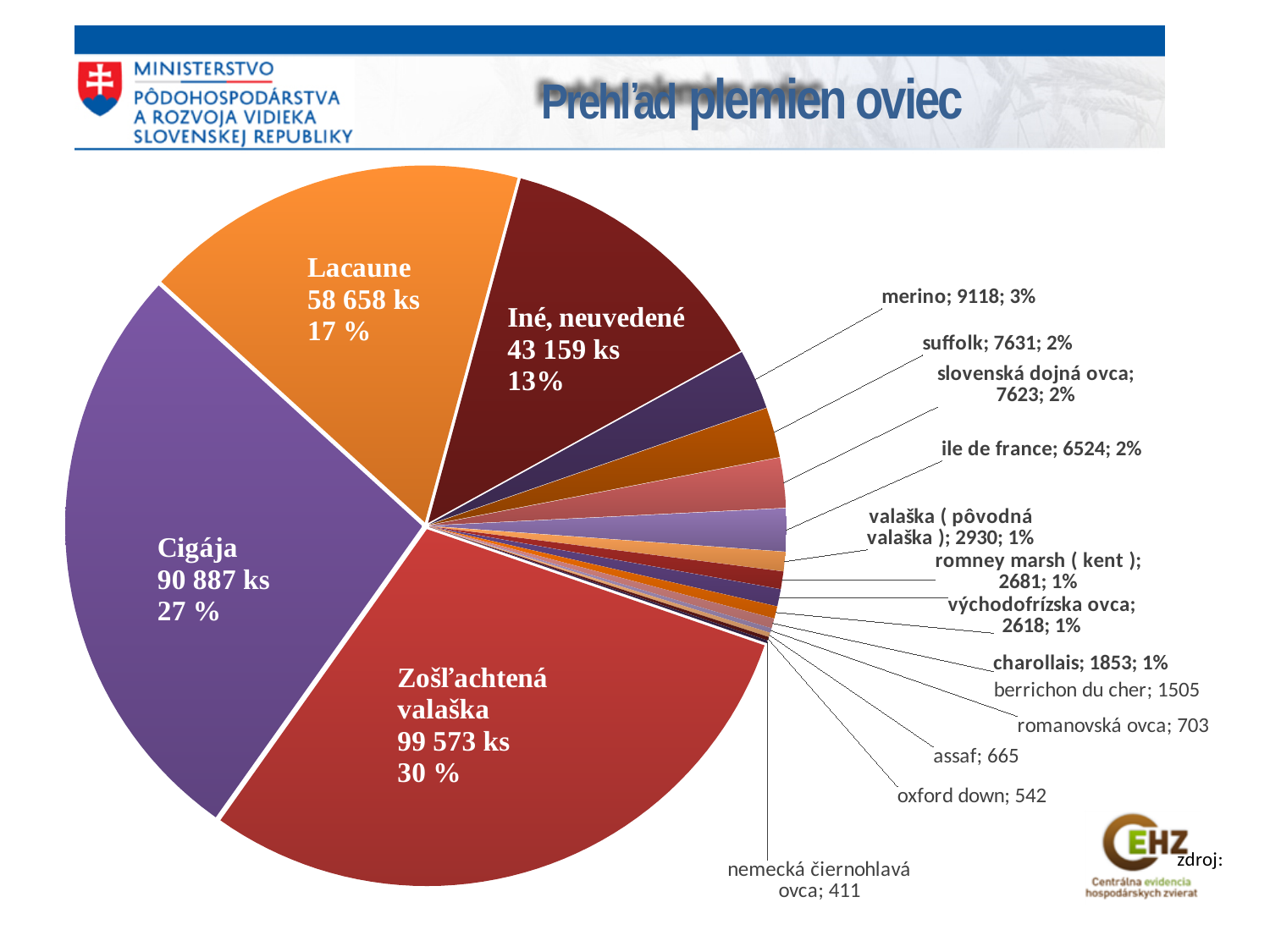
What value is shown for merino? 9118 What share of the pie does Cigája represent? 27 % How many head (ks) are shown for Lacaune? 58 658 ks Which breed has the smallest slice of the pie? nemecká čiernohlavá ovca How many head (ks) are shown for Cigája? 90 887 ks Which breed has the largest slice of the pie? Zošľachtená valaška What is the title of the chart? Prehľad plemien oviec What value is shown for oxford down? 542 What is the difference in head count between Zošľachtená valaška and Cigája? 8 686 ks Which is larger, the value for suffolk or the value for slovenská dojná ovca? suffolk What share of the pie does Iné, neuvedené represent? 13% What kind of chart is shown on the slide? pie chart